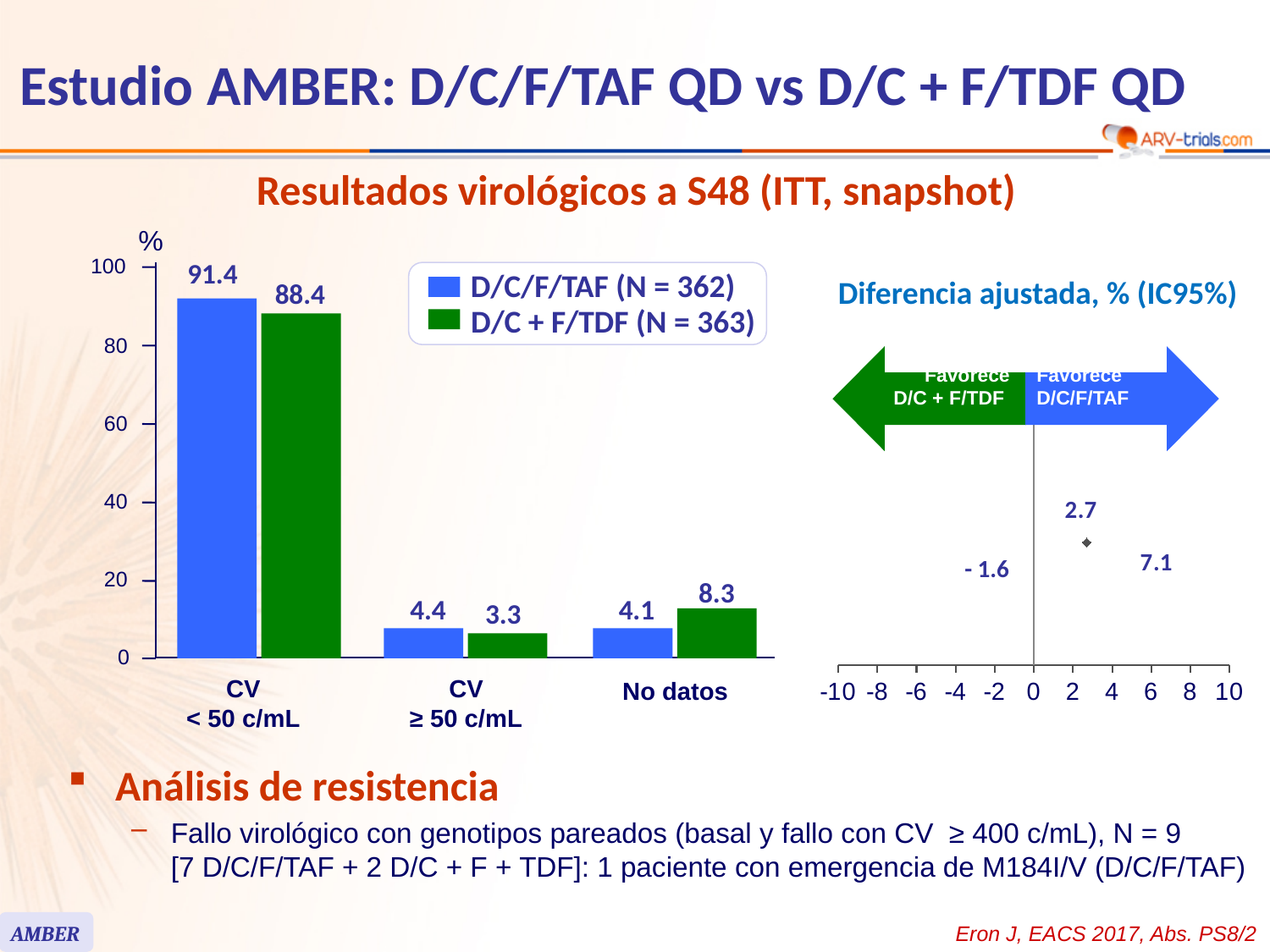
In the bar chart on the left, which series has the larger value in the No datos category? D/C + F/TDF (N = 363) In the bar chart on the left, what is the value for D/C + F/TDF (N = 363) in the CV < 50 c/mL category? 88.4 How many categories are shown on the x axis of the bar chart on the left? 3 In the bar chart on the left, what is the difference between the D/C/F/TAF and D/C + F/TDF values in the CV < 50 c/mL category? 3.0 How many series does the legend of the bar chart on the left list? 2 In the bar chart on the left, what is the value for D/C/F/TAF (N = 362) in the CV ≥ 50 c/mL category? 4.4 What kind of chart is shown on the left of the slide? Bar chart In the bar chart on the left, what is the value for D/C + F/TDF (N = 363) in the No datos category? 8.3 In the bar chart on the left, what is the value for D/C/F/TAF (N = 362) in the CV < 50 c/mL category? 91.4 In the bar chart on the left, which category has the lowest value for D/C + F/TDF (N = 363)? CV ≥ 50 c/mL In the chart on the right titled 'Diferencia ajustada, % (IC95%)', what is the point estimate of the adjusted difference? 2.7 In the bar chart on the left, which category has the highest value for D/C/F/TAF (N = 362)? CV < 50 c/mL